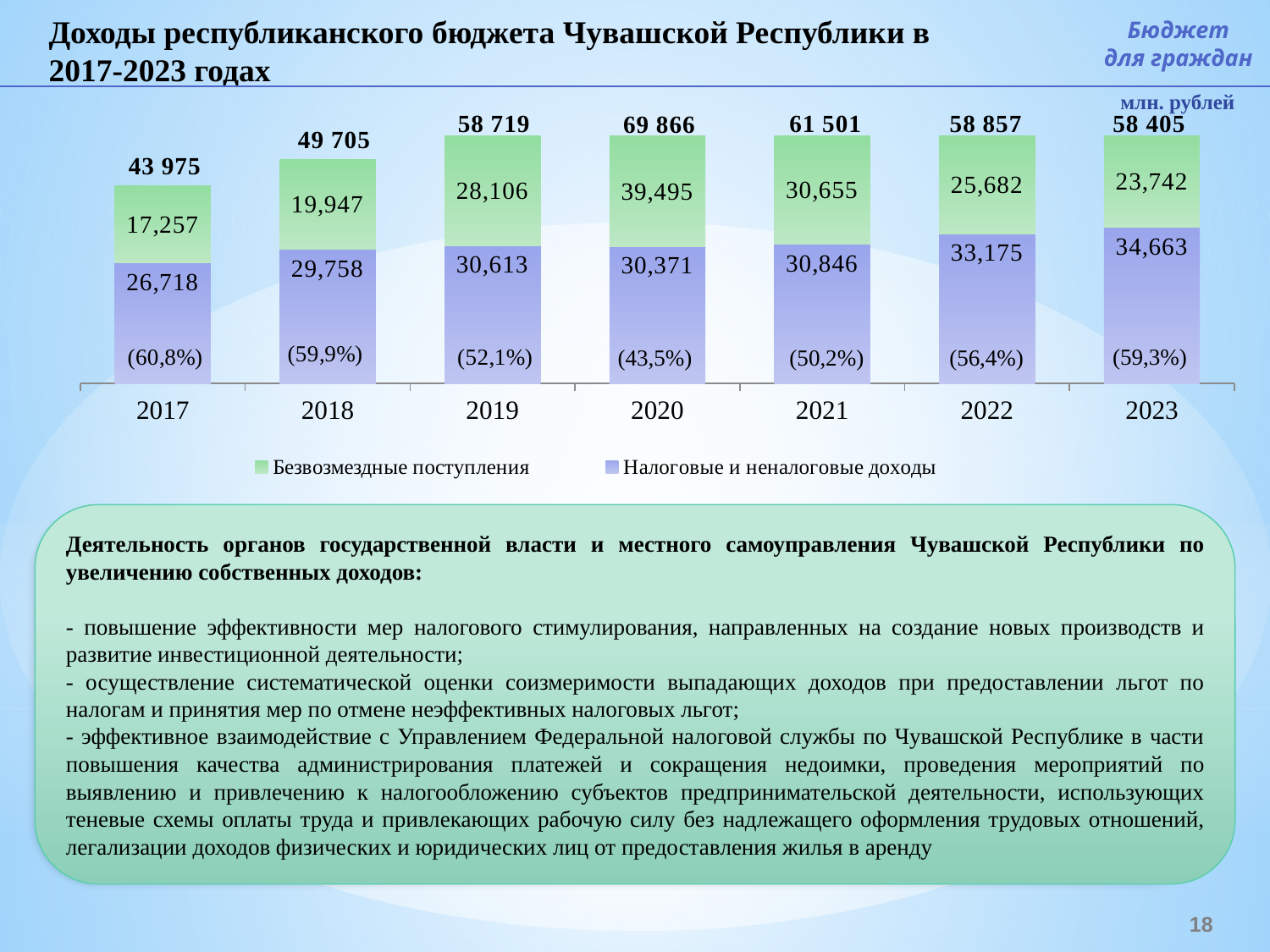
How many years are shown on the x axis of the chart? 7 What is the difference between the total revenue in 2020 and in 2021? 8 365 Which is larger in 2022: Безвозмездные поступления or Налоговые и неналоговые доходы? Налоговые и неналоговые доходы What is the total revenue shown above the bar for 2020? 69 866 Which year has the lowest total revenue? 2017 Which year has the highest value of Налоговые и неналоговые доходы? 2023 What percentage is shown in parentheses at the bottom of the 2017 bar? (60,8%) What is the value of Налоговые и неналоговые доходы for 2023? 34,663 How many series does the legend list? 2 Which year has the highest total revenue? 2020 What kind of chart is shown on the slide? Stacked bar chart What is the value of Безвозмездные поступления for 2019? 28,106